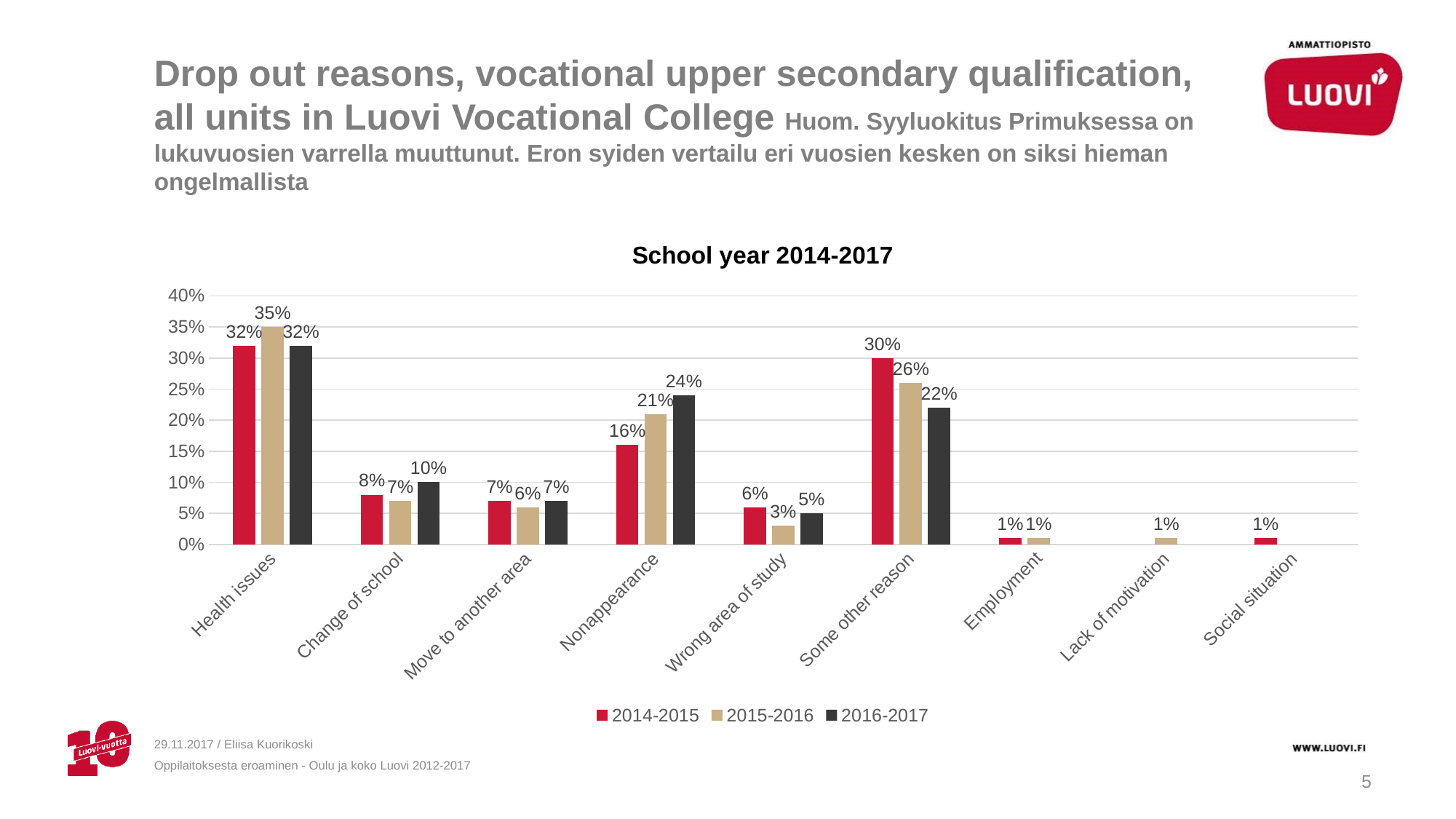
What is the value for Some other reason in the 2014-2015 series? 30% What is the difference between the 2016-2017 and 2014-2015 values for Nonappearance? 8 percentage points What kind of chart is shown on the slide? Bar chart What is the value for Health issues in the 2015-2016 series? 35% Which category has the lowest value in the 2014-2015 series? Employment and Social situation (1%) Which category has the highest value in the 2016-2017 series? Health issues What is the value for Nonappearance in the 2016-2017 series? 24% What is the title of the chart? School year 2014-2017 How many categories are shown on the x axis? 9 How many series does the legend list? 3 For Some other reason, which series has the larger value: 2014-2015 or 2016-2017? 2014-2015 What is the value for Wrong area of study in the 2015-2016 series? 3%